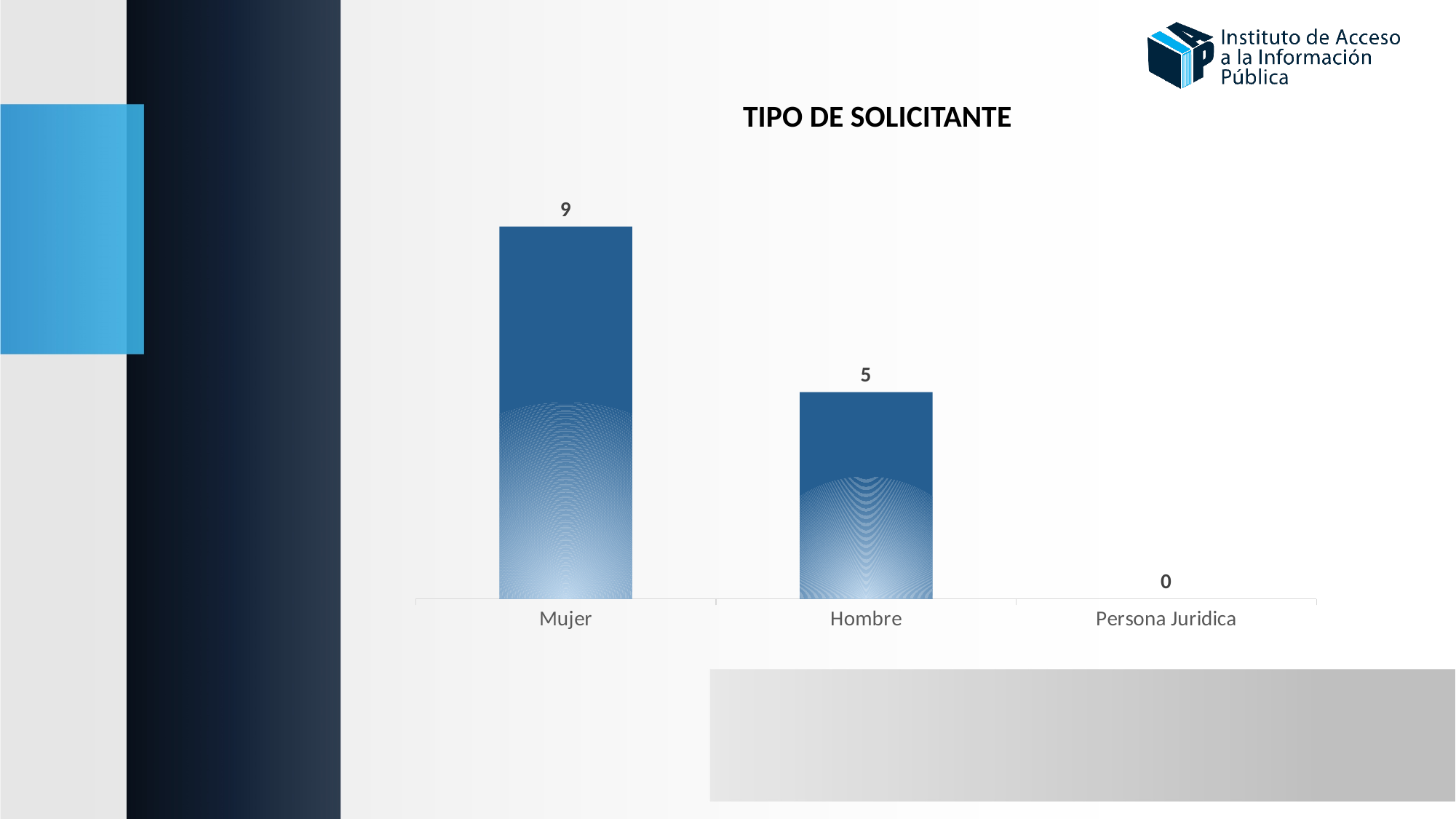
Do the values rise or fall from left to right along the x axis? Fall What is the value for Hombre? 5 Which is larger, the value for Hombre or the value for Persona Juridica? Hombre What is the difference between the values for Mujer and Hombre? 4 What is the title of the chart? TIPO DE SOLICITANTE What is the value for Persona Juridica? 0 Which category has the lowest value? Persona Juridica Which category has the highest value? Mujer What is the value for Mujer? 9 How many categories are shown on the x axis? 3 What kind of chart is shown on the slide? Bar chart What is the total of the values for Mujer, Hombre and Persona Juridica? 14